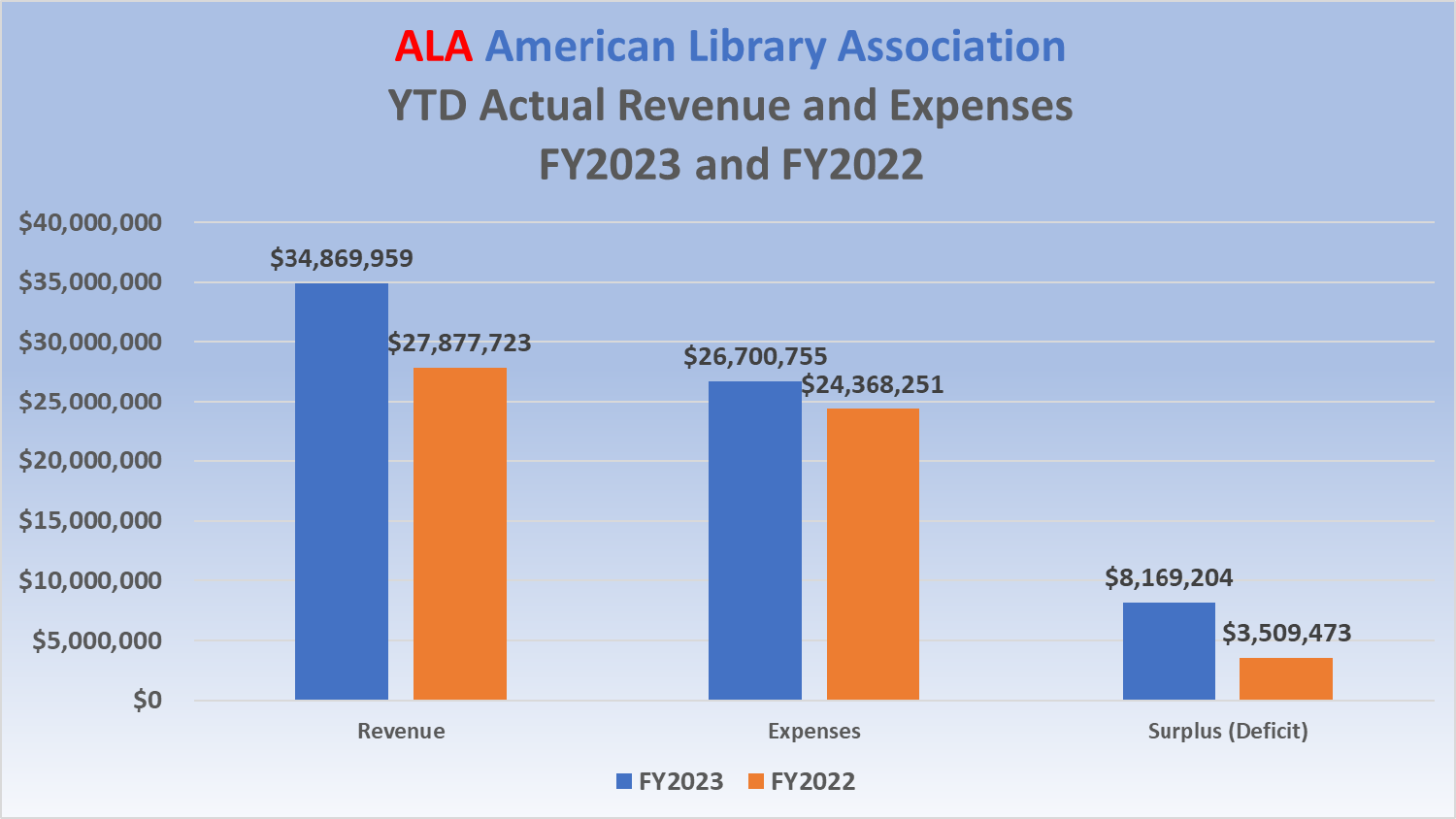
How many categories are shown on the x axis? 3 What is the FY2023 value for Revenue? $34,869,959 Which category has the lowest FY2022 value? Surplus (Deficit) How many series does the legend list? 2 What is the difference between the FY2023 and FY2022 values for Surplus (Deficit)? $4,659,731 Which category has the highest FY2023 value? Revenue Which is larger, the FY2023 value for Expenses or the FY2022 value for Revenue? FY2022 value for Revenue Is the FY2023 value for Expenses greater or less than $25,000,000? greater What is the FY2022 value for Expenses? $24,368,251 What is the FY2022 value for Surplus (Deficit)? $3,509,473 What kind of chart is shown on the slide? Bar chart What is the difference between the FY2023 and FY2022 values for Revenue? $6,992,236